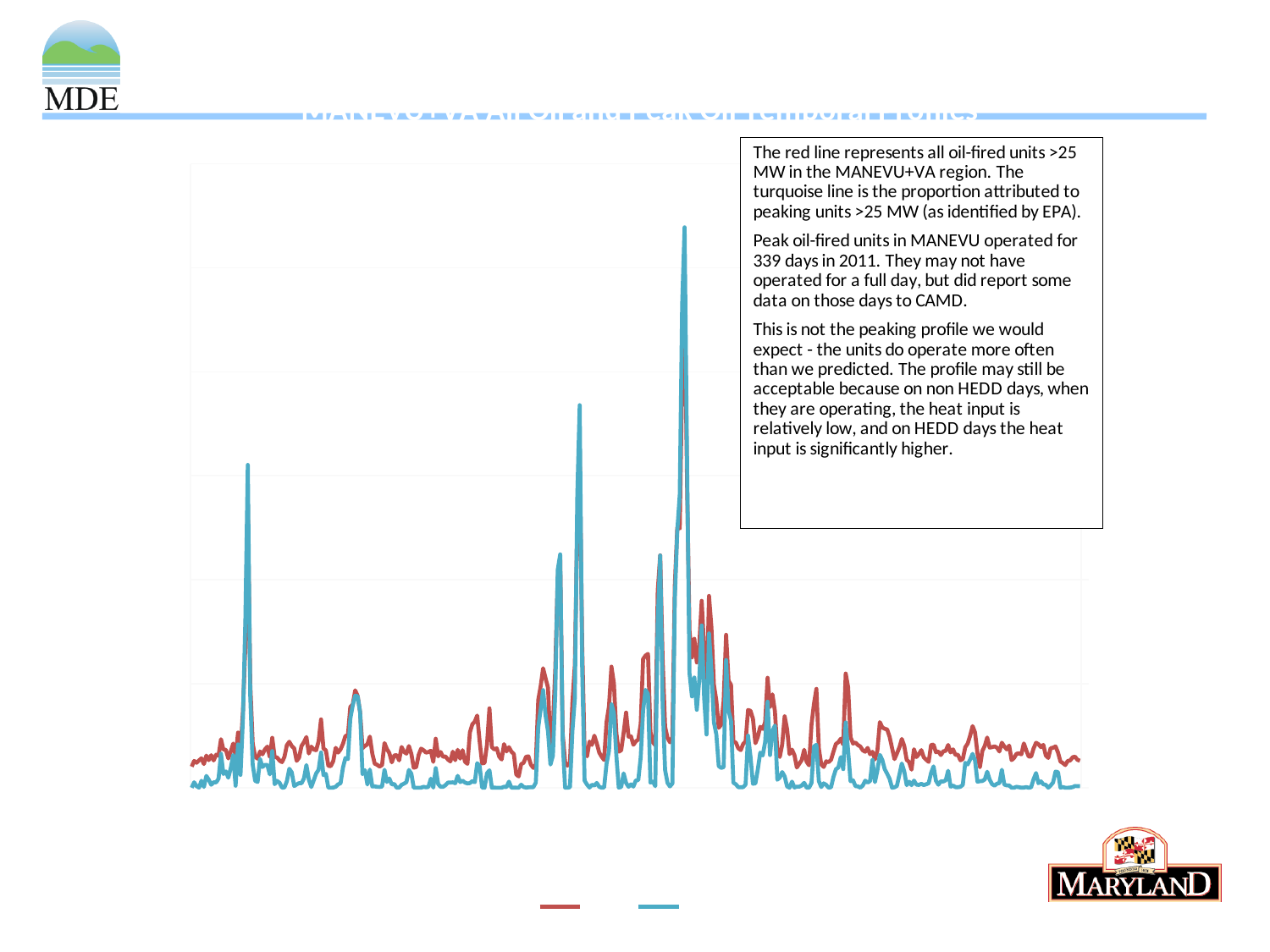
What kind of chart is shown on the slide? line chart How many series does the legend at the bottom of the chart list? 2 Which line sits higher across most of the chart, the red line or the turquoise line? red What colours are the two lines plotted on the chart? red and turquoise